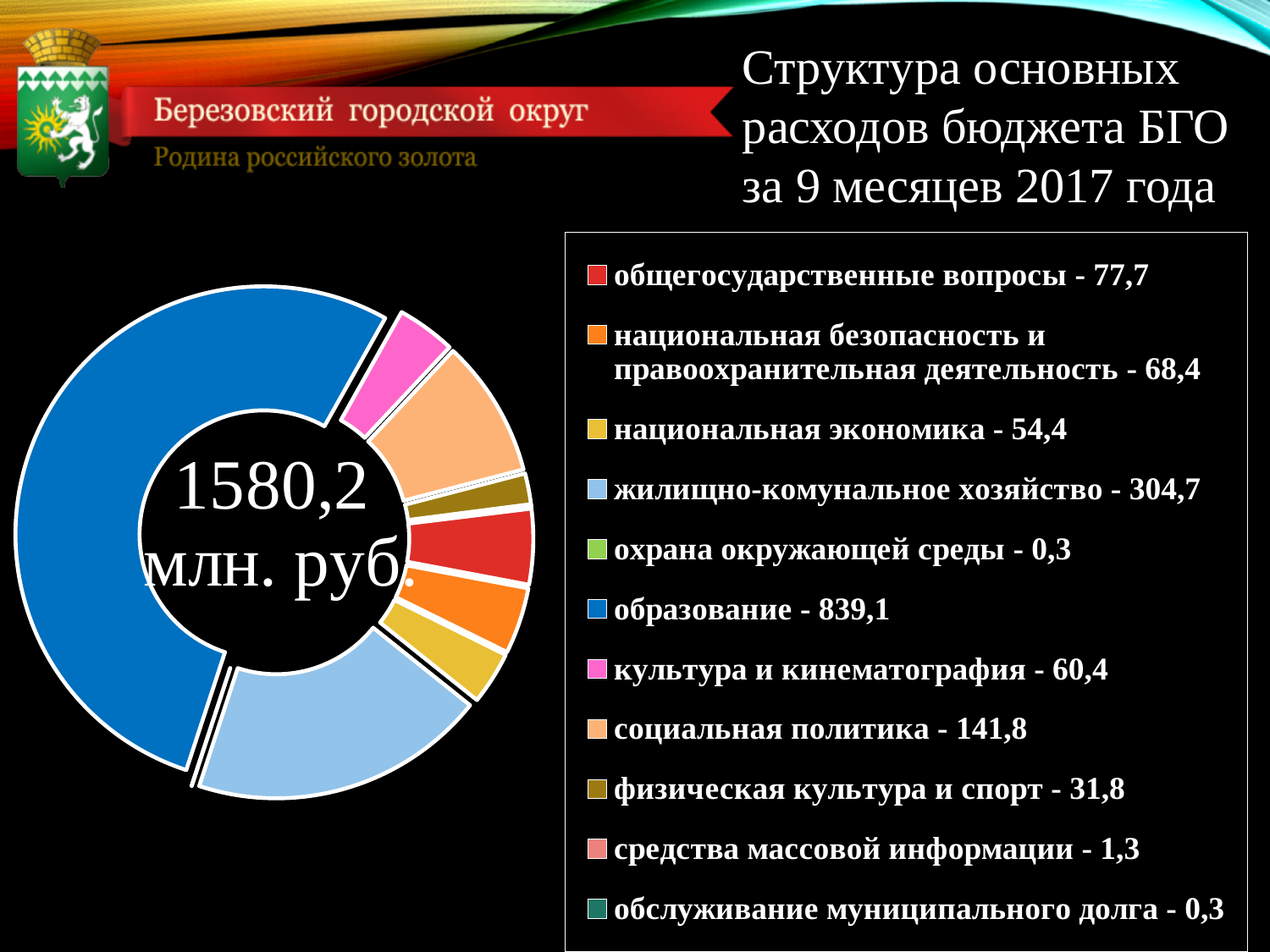
How many categories does the legend list? 11 What is the value for физическая культура и спорт? 31,8 Which category has the highest value in the chart? образование What is the value for средства массовой информации? 1,3 What is the difference between жилищно-комунальное хозяйство and социальная политика? 162,9 What is the value for жилищно-комунальное хозяйство? 304,7 What total is printed in the centre of the chart? 1580,2 млн. руб. Which is larger: общегосударственные вопросы or национальная безопасность и правоохранительная деятельность? общегосударственные вопросы What is the value for образование in the chart? 839,1 Which is larger: культура и кинематография or национальная экономика? культура и кинематография What is the value for социальная политика? 141,8 What kind of chart is shown on the slide? Doughnut (pie) chart